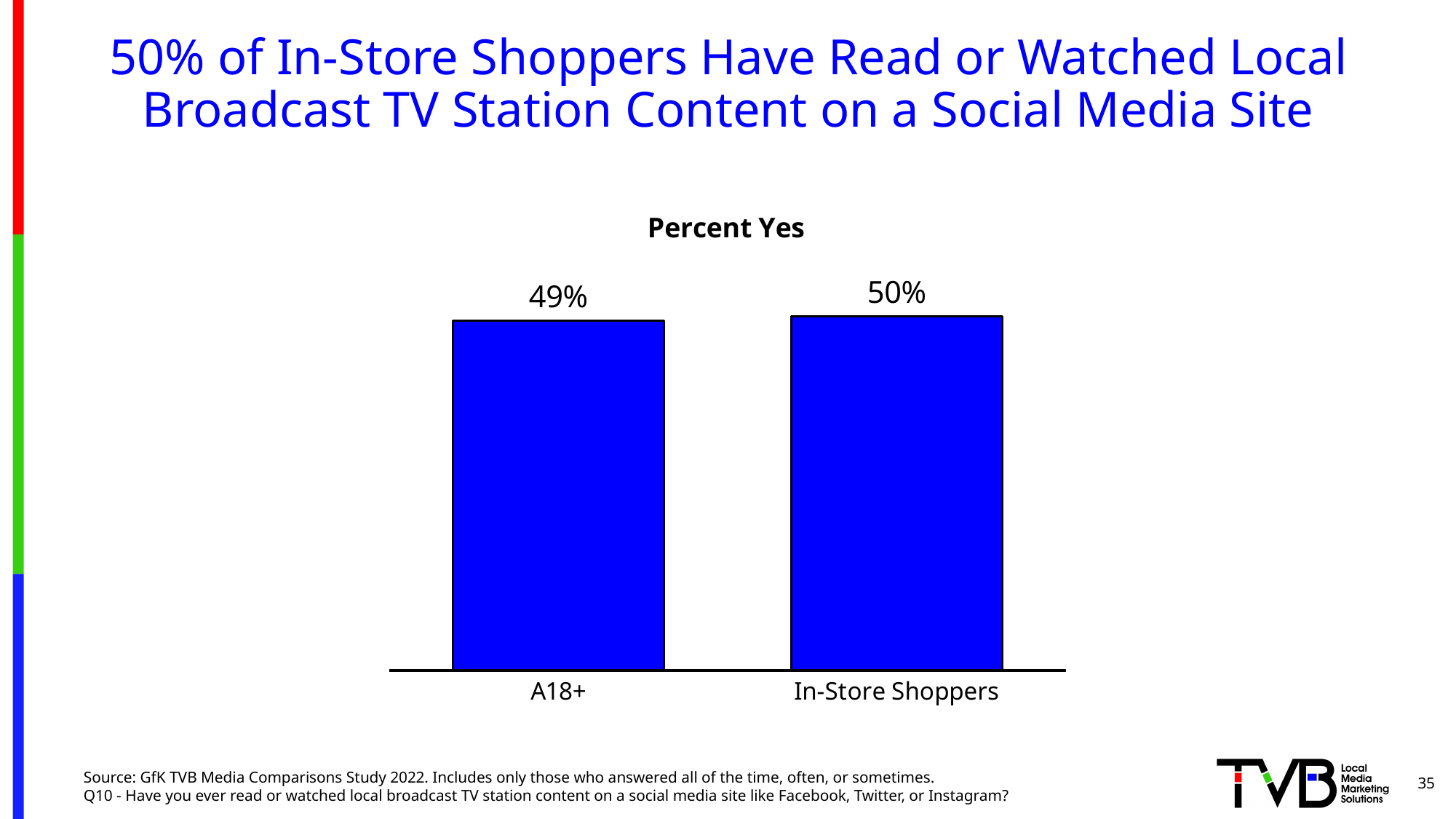
Which category has the lower value? A18+ Is the value for In-Store Shoppers larger or smaller than the value for A18+? larger What kind of chart is shown on the slide? bar chart What is the title of the chart? Percent Yes Which category has the higher value? In-Store Shoppers What is the difference between the values for In-Store Shoppers and A18+? 1% What is the value for A18+? 49% What colour are the bars in the chart? blue What is the value for In-Store Shoppers? 50% How many categories are shown in the chart? 2